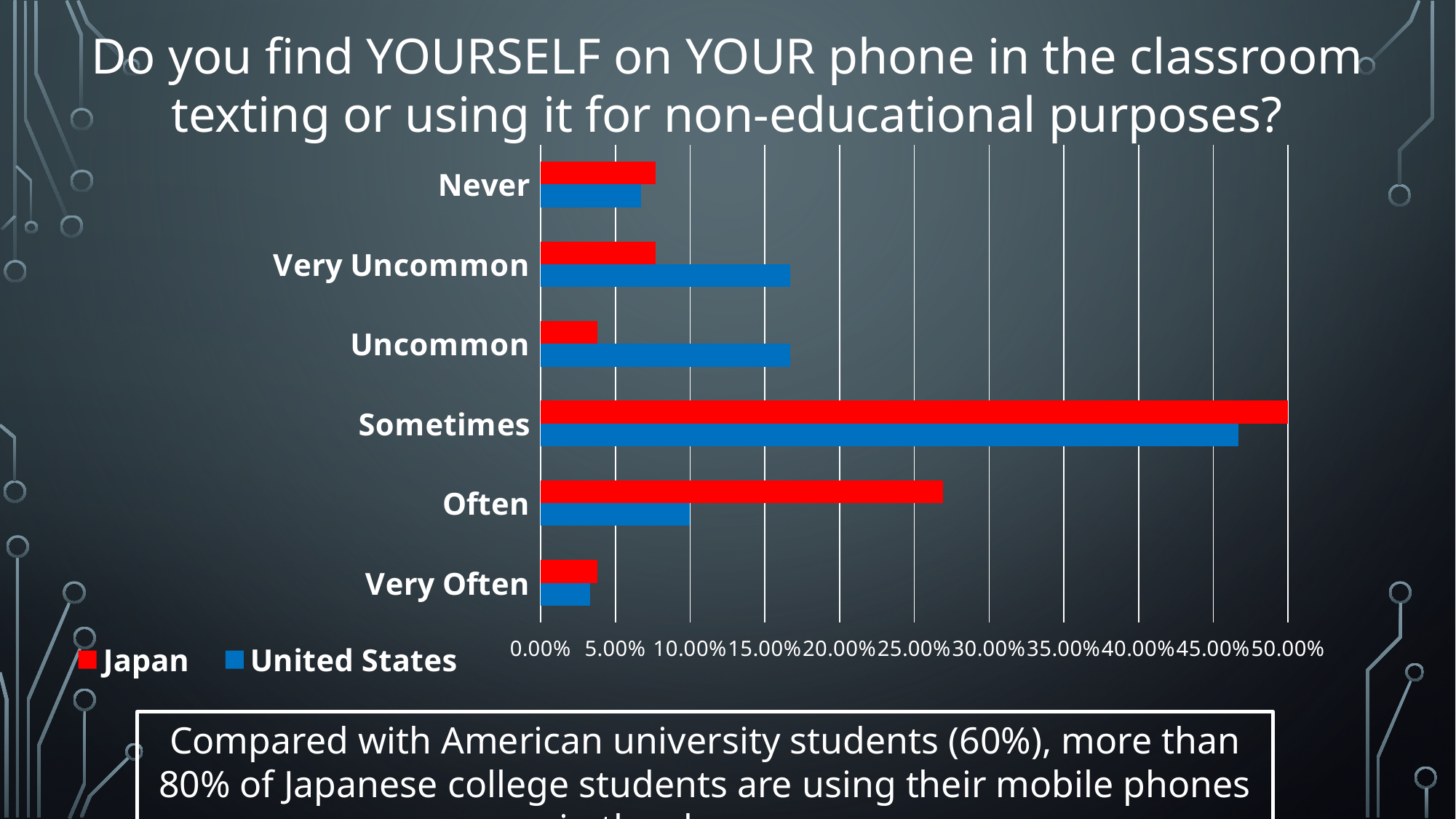
What is the value for United States in the Often category? 10.00% What is the value for Japan in the Sometimes category? 50.00% Which category has the lowest value for United States? Very Often For the Often category, which is larger, Japan or United States? Japan Which colour represents Japan in the legend? red What kind of chart is shown on the slide? bar chart Which category has the highest value for Japan? Sometimes How many response categories are shown on the chart? 6 Which category has the highest value for United States? Sometimes For the Very Uncommon category, which is larger, Japan or United States? United States Is the value for Japan in the Often category greater or less than 20.00%? greater How many series does the legend list? 2